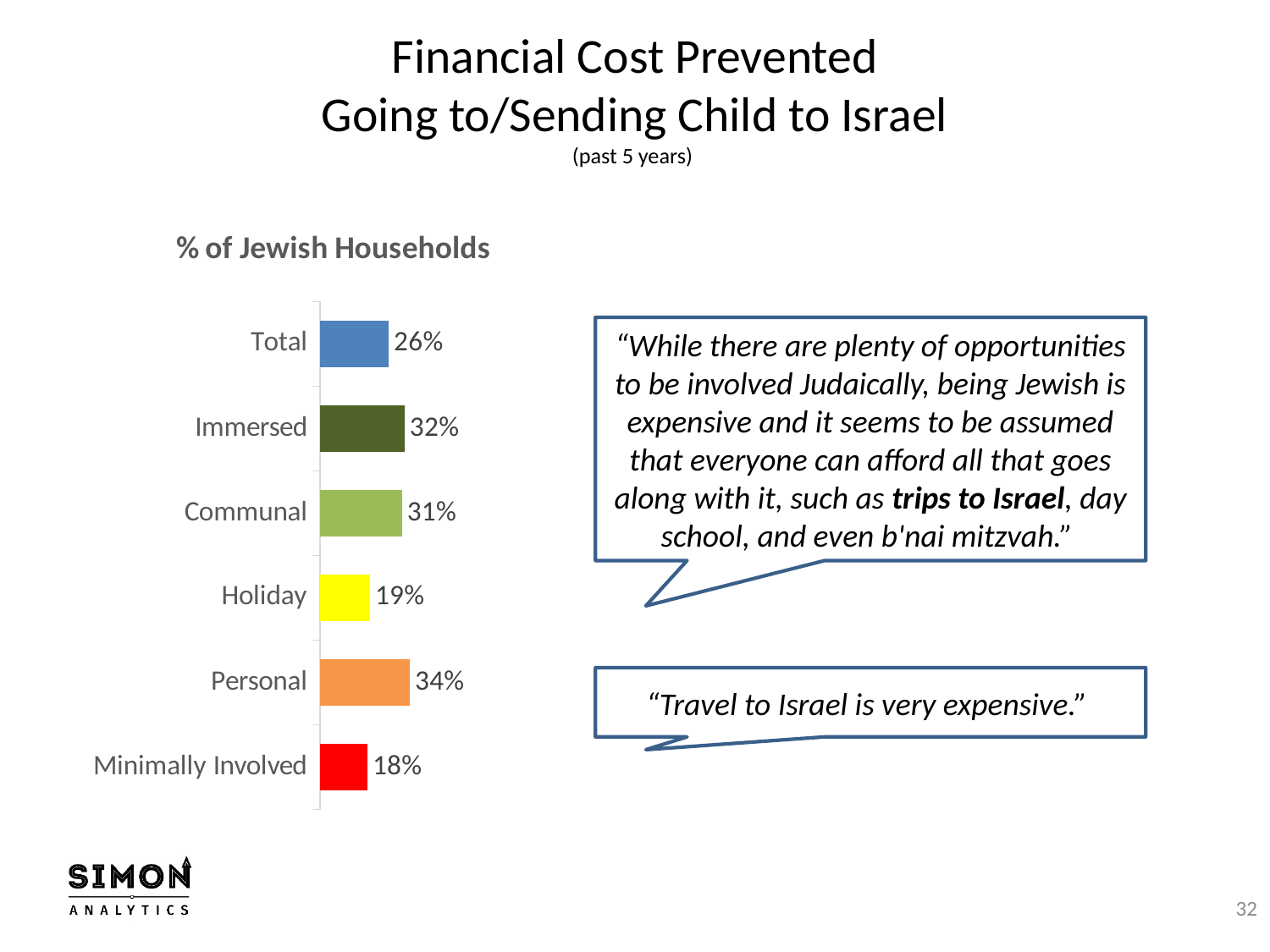
Which category has the highest value? Personal What is the value for Minimally Involved? 18% What is the title of the chart? % of Jewish Households Which category has the lowest value? Minimally Involved What is the value for Total? 26% What is the value for Immersed? 32% What is the difference between the values for Immersed and Communal? 1% Which is larger, the value for Communal or the value for Total? Communal What kind of chart is shown on the slide? Bar chart What is the value for Holiday? 19% How many categories are shown in the chart? 6 What is the difference between the values for Personal and Holiday? 15%